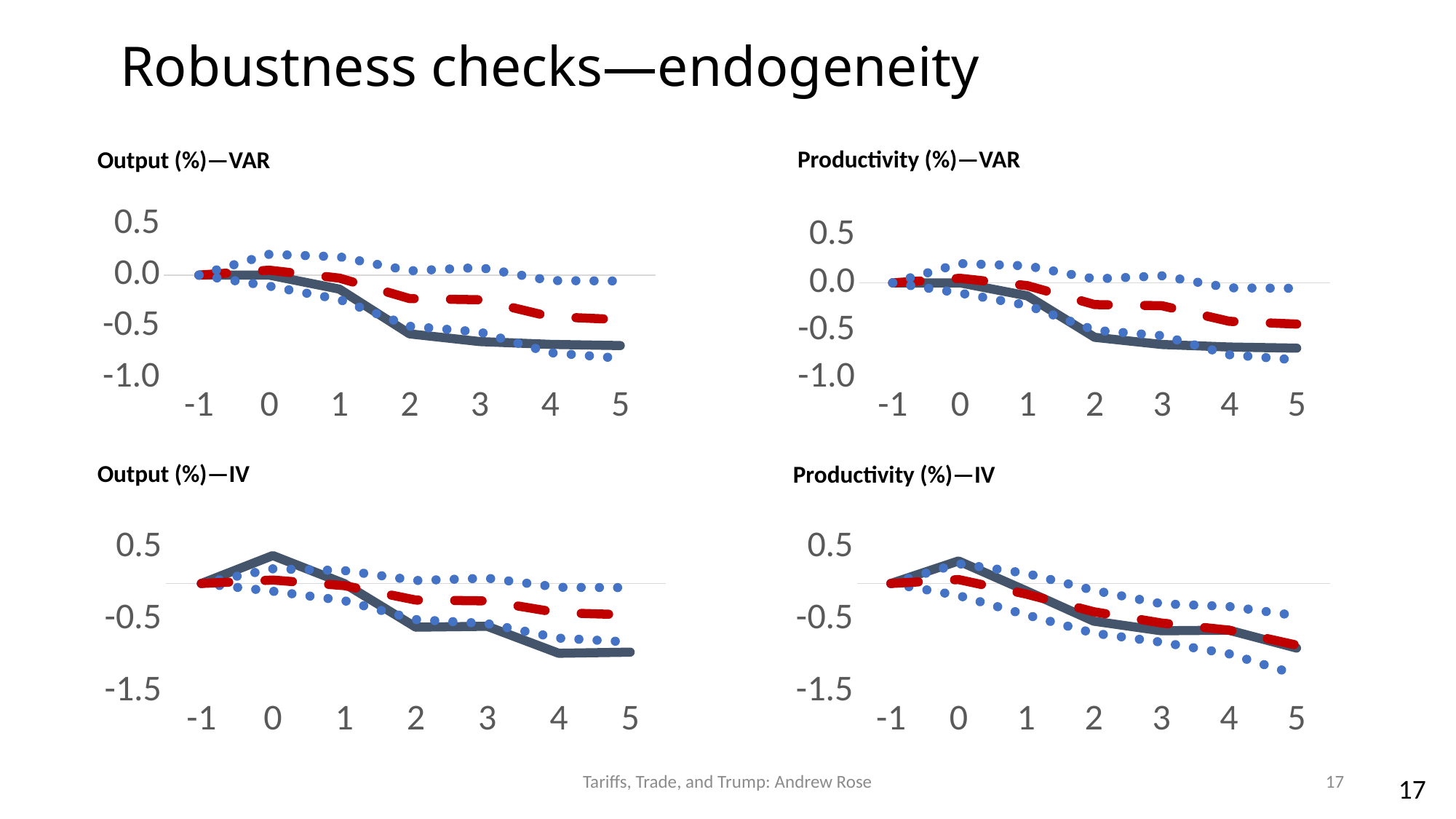
In the "Productivity (%)—IV" chart, is the value of the solid line at x = 5 greater or less than -1.5? greater In the "Productivity (%)—VAR" chart, what is the value of the solid line at x = -1? 0.0 In the "Output (%)—IV" chart, is the value of the solid line at x = 0 greater or less than 0.5? less In the "Productivity (%)—VAR" chart, is the value of the solid line at x = 5 greater or less than -0.5? less In the "Productivity (%)—IV" chart, does the solid line rise or fall from x = 0 to x = 5? fall In the "Output (%)—VAR" chart, how many points are labelled on the x axis? 7 How many charts are shown on the slide? 4 In the "Output (%)—VAR" chart, does the solid line rise or fall from x = 0 to x = 5? fall What kind of chart is the "Output (%)—VAR" chart? line chart What is the title of the chart in the bottom-right position of the slide? Productivity (%)—IV